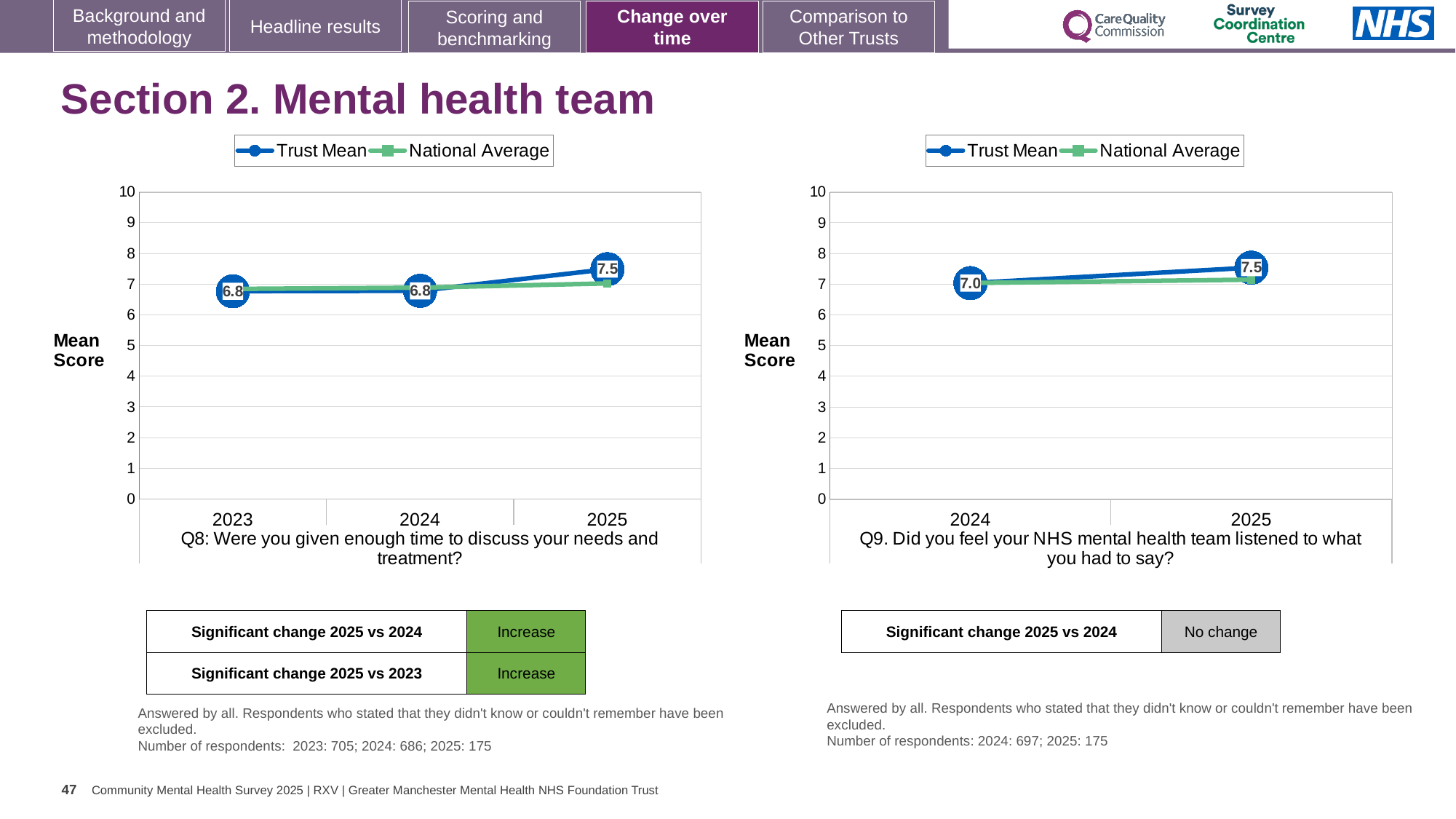
In the Q8 chart on the left, is the National Average for 2025 greater or less than 8? less In the Q8 chart on the left, what is the Trust Mean for 2025? 7.5 In the Q8 chart on the left, which year has the highest Trust Mean? 2025 In the Q9 chart on the right, does the Trust Mean rise or fall from 2024 to 2025? Rise In the Q8 chart on the left, what is the Trust Mean for 2023? 6.8 In the Q9 chart on the right, what is the Trust Mean for 2025? 7.5 In the Q8 chart on the left, by how much did the Trust Mean change from 2024 to 2025? 0.7 In the Q9 chart on the right, what is the Trust Mean for 2024? 7.0 What type of chart is the Q8 chart on the left? Line chart How many series does the legend of the Q9 chart on the right list? 2 How many years are plotted on the x axis of the Q8 chart on the left? 3 In the Q9 chart on the right, what is the difference between the Trust Mean in 2025 and 2024? 0.5